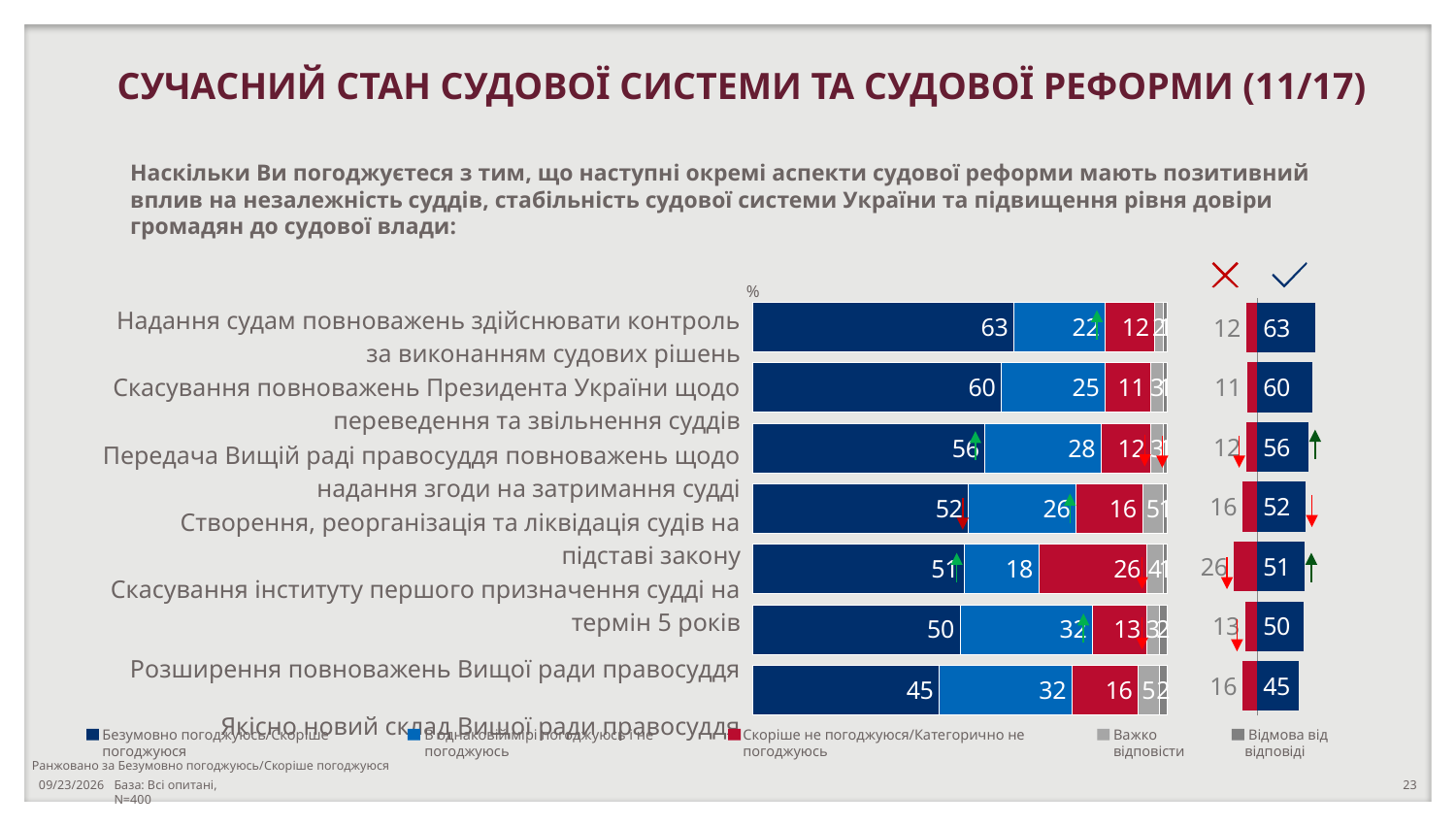
What is the difference in the agree share between 'Надання судам повноважень здійснювати контроль за виконанням судових рішень' and 'Якісно новий склад Вищої ради правосуддя'? 18 What is the value of the 'В однаковій мірі погоджуюсь і не погоджуюсь' segment for 'Розширення повноважень Вищої ради правосуддя'? 32 What percentage of respondents agree (Безумовно погоджуюсь/Скоріше погоджуюся) with 'Надання судам повноважень здійснювати контроль за виконанням судових рішень'? 63 How many series does the legend list? 5 What is the first entry in the chart legend? Безумовно погоджуюсь/Скоріше погоджуюся How many aspects of judicial reform are shown in the chart? 7 Which aspect of judicial reform has the lowest share of respondents who agree? Якісно новий склад Вищої ради правосуддя Which aspect of judicial reform has the highest share of respondents who agree? Надання судам повноважень здійснювати контроль за виконанням судових рішень What type of chart is shown on the slide? Stacked bar chart Which aspect has the highest share of respondents who disagree? Скасування інституту першого призначення судді на термін 5 років Which has a larger agree share: 'Передача Вищій раді правосуддя повноважень щодо надання згоди на затримання судді' or 'Створення, реорганізація та ліквідація судів на підставі закону'? Передача Вищій раді правосуддя повноважень щодо надання згоди на затримання судді What percentage of respondents disagree (Скоріше не погоджуюся/Категорично не погоджуюсь) with 'Скасування інституту першого призначення судді на термін 5 років'? 26